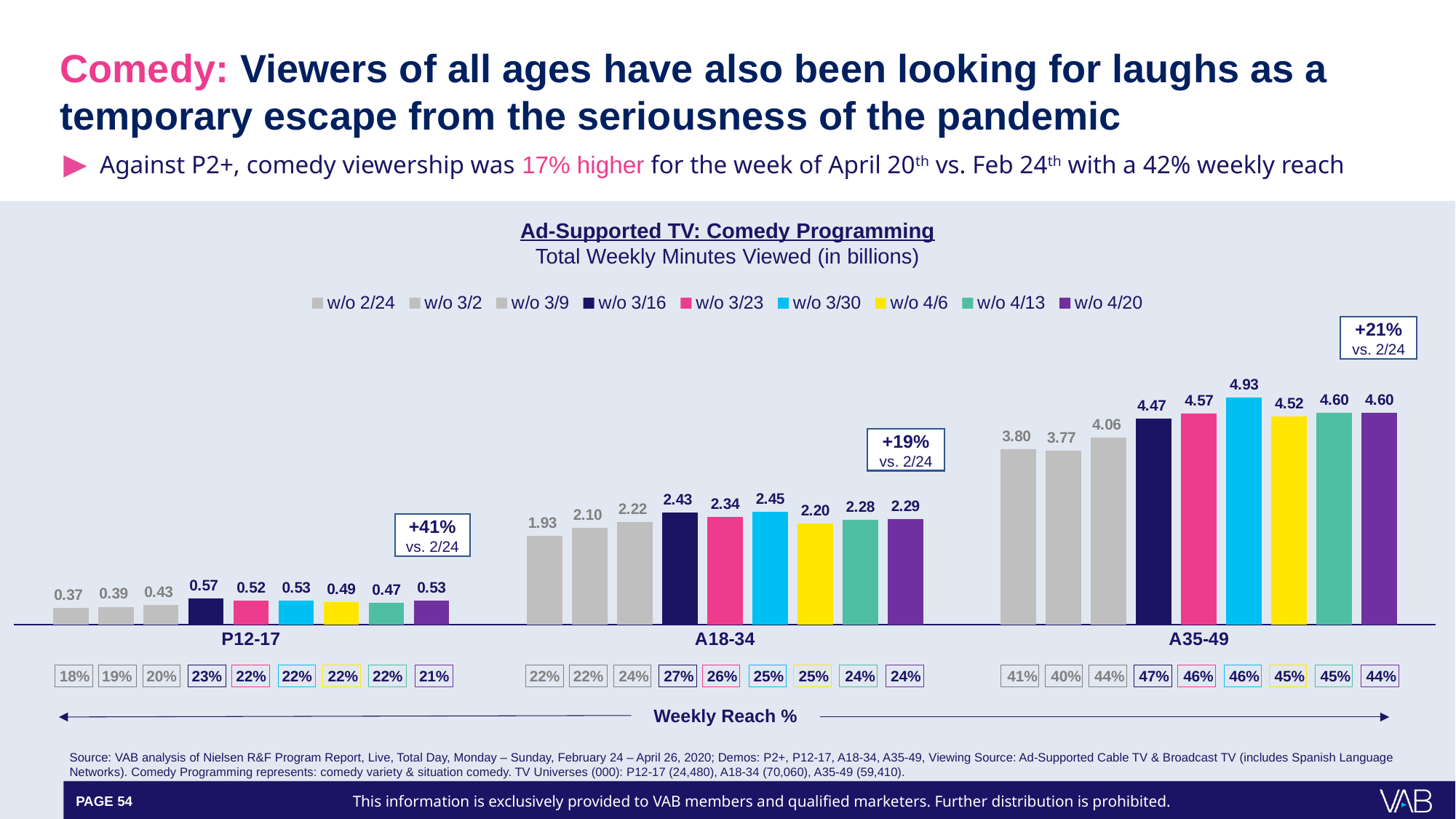
How many demographic groups are shown on the x axis? 3 What is the difference between w/o 4/20 and w/o 2/24 in the A35-49 group? 0.80 In the A18-34 group, which is larger: w/o 3/16 or w/o 3/23? w/o 3/16 Which week has the lowest value in the A18-34 group? w/o 2/24 What percentage change vs. 2/24 is annotated above the P12-17 group? +41% What is the value for w/o 4/20 in the A18-34 group? 2.29 How many series does the legend list? 9 In the P12-17 group, do the values rise or fall from w/o 2/24 to w/o 3/16? Rise What kind of chart is shown on the slide? Bar chart What is the value for w/o 2/24 in the P12-17 group? 0.37 Which week has the highest value in the A35-49 group? w/o 3/30 What is the value for w/o 3/30 in the A35-49 group? 4.93